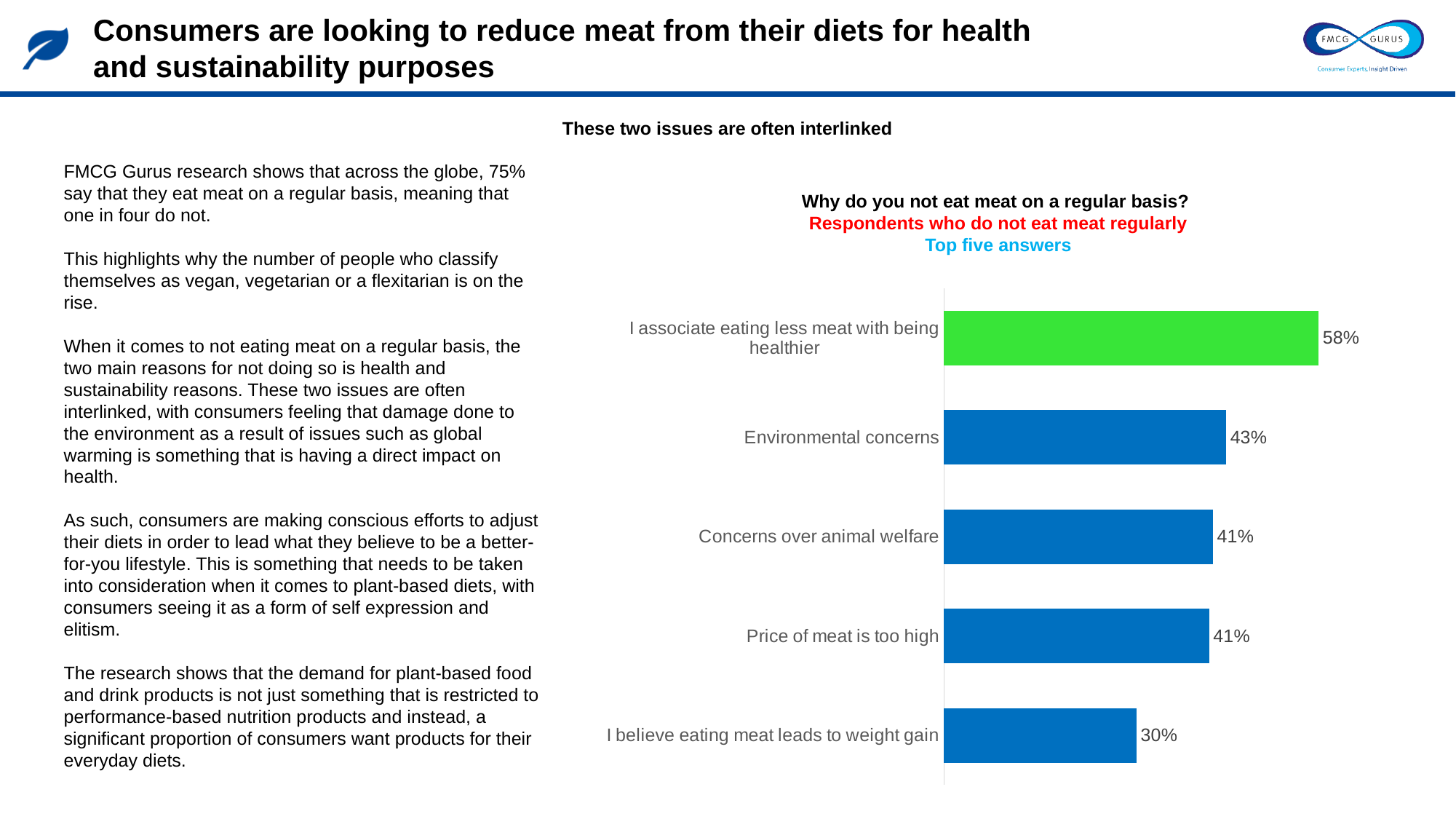
Which answer has the highest percentage? I associate eating less meat with being healthier What percentage of respondents said they associate eating less meat with being healthier? 58% What percentage of respondents cited 'I believe eating meat leads to weight gain'? 30% What is the difference between 'I associate eating less meat with being healthier' and 'Environmental concerns'? 15 percentage points What kind of chart is shown on the slide? Bar chart How many answers are shown in the chart? 5 Which bar is coloured green rather than blue? I associate eating less meat with being healthier What is the value for 'Environmental concerns'? 43% Which is larger: 'Environmental concerns' or 'Concerns over animal welfare'? Environmental concerns What is the value for 'Price of meat is too high'? 41% What is the difference between 'Environmental concerns' and 'I believe eating meat leads to weight gain'? 13 percentage points Which answer has the lowest percentage? I believe eating meat leads to weight gain